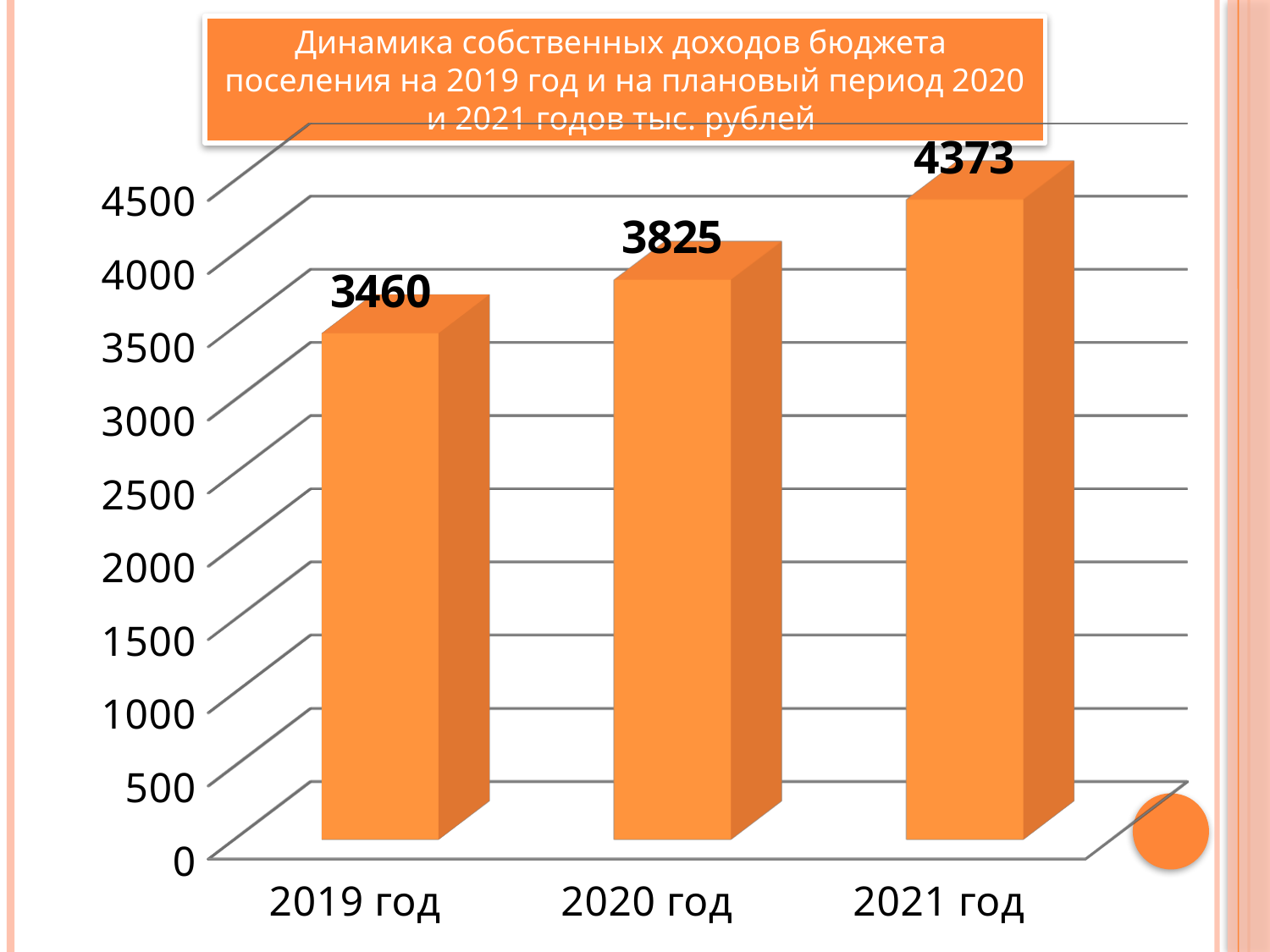
What is the value for 2021 год? 4373 Which year has the lowest value? 2019 год Which is larger, the value for 2020 год or the value for 2021 год? 2021 год How many years are shown on the chart? 3 Which year has the highest value? 2021 год What is the value for 2019 год? 3460 What is the difference between the values for 2021 год and 2019 год? 913 What is the value for 2020 год? 3825 What is the difference between the values for 2020 год and 2019 год? 365 What kind of chart is shown on the slide? bar chart Do the values rise or fall from 2019 год to 2021 год? rise Is the value for 2019 год greater or less than 3500? less